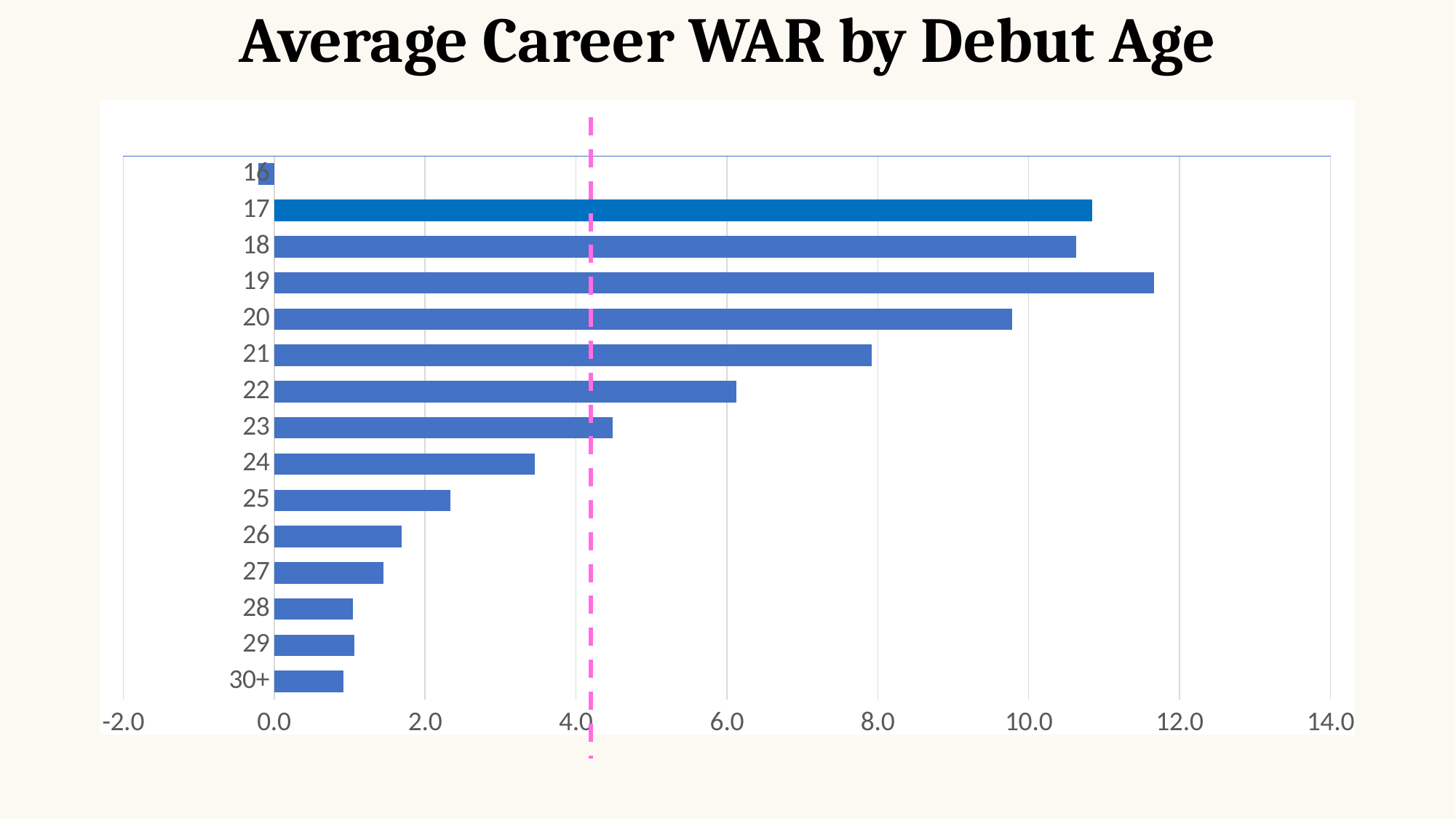
What is the title of the chart? Average Career WAR by Debut Age What type of chart is shown on the slide? Bar chart Is the value for debut age 17 greater or less than 10.0? greater Which has a larger average career WAR, debut age 20 or debut age 21? 20 Which debut age has the lowest average career WAR? 16 Which debut age has the highest average career WAR? 19 Which has a larger average career WAR, debut age 24 or debut age 25? 24 Is the value for debut age 24 greater or less than 4.0? less Is the value for debut age 27 greater or less than 2.0? less How many debut age categories are plotted in the chart? 15 From debut age 19 down to 30+, do the bar values generally rise or fall? fall